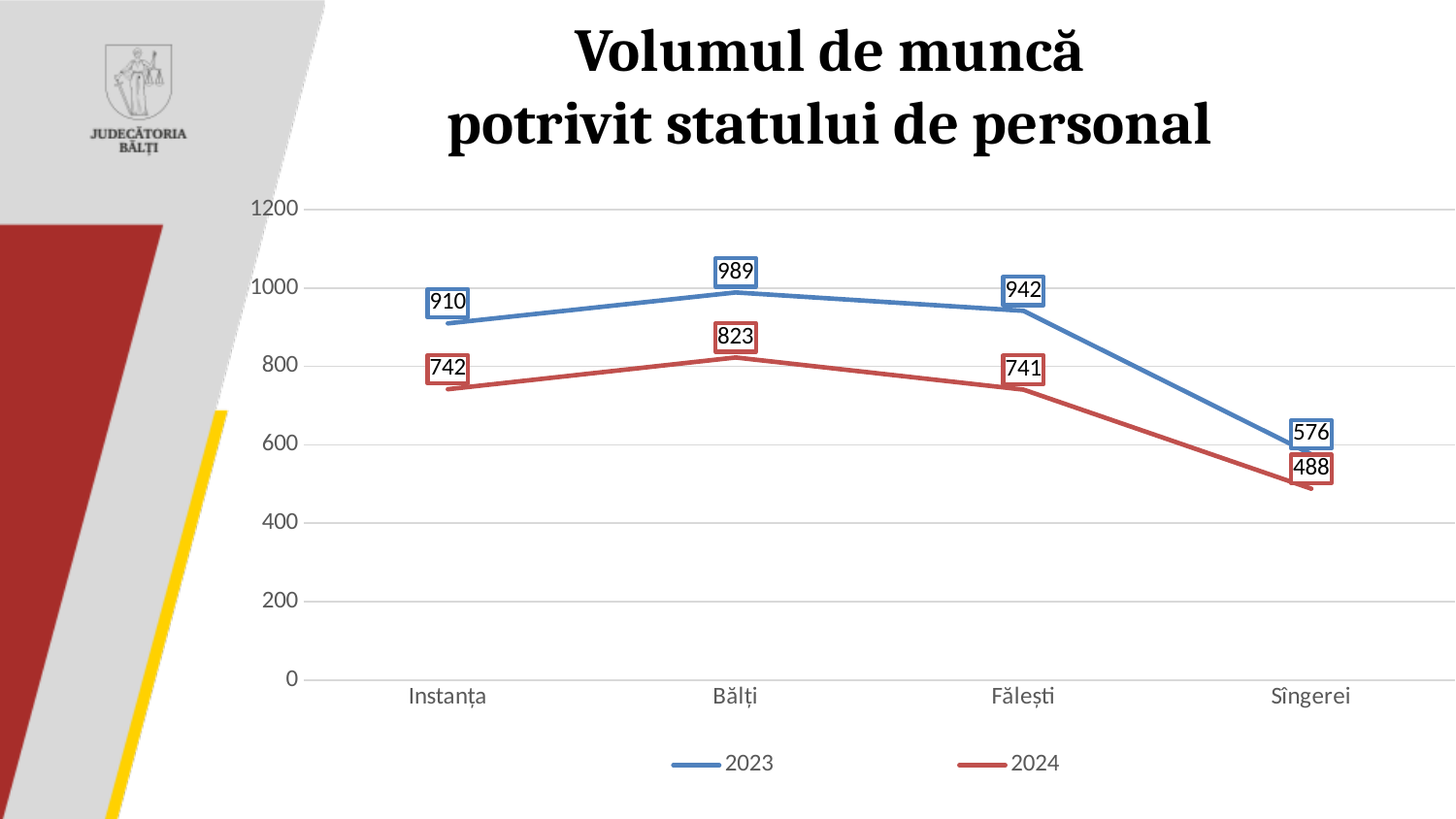
What is the difference between the 2023 and 2024 values for Instanța? 168 What is the value for Bălți in the 2023 series? 989 Which category has the highest value in the 2023 series? Bălți How many categories are shown on the x axis? 4 Is the 2024 value for Bălți greater or less than 800? greater What kind of chart is shown on the slide? line chart What is the value for Fălești in the 2024 series? 741 What is the title of the chart? Volumul de muncă potrivit statului de personal What is the value for Sîngerei in the 2024 series? 488 How many series does the legend list? 2 Which is larger: the 2023 value for Fălești or the 2023 value for Instanța? Fălești Which category has the lowest value in the 2024 series? Sîngerei